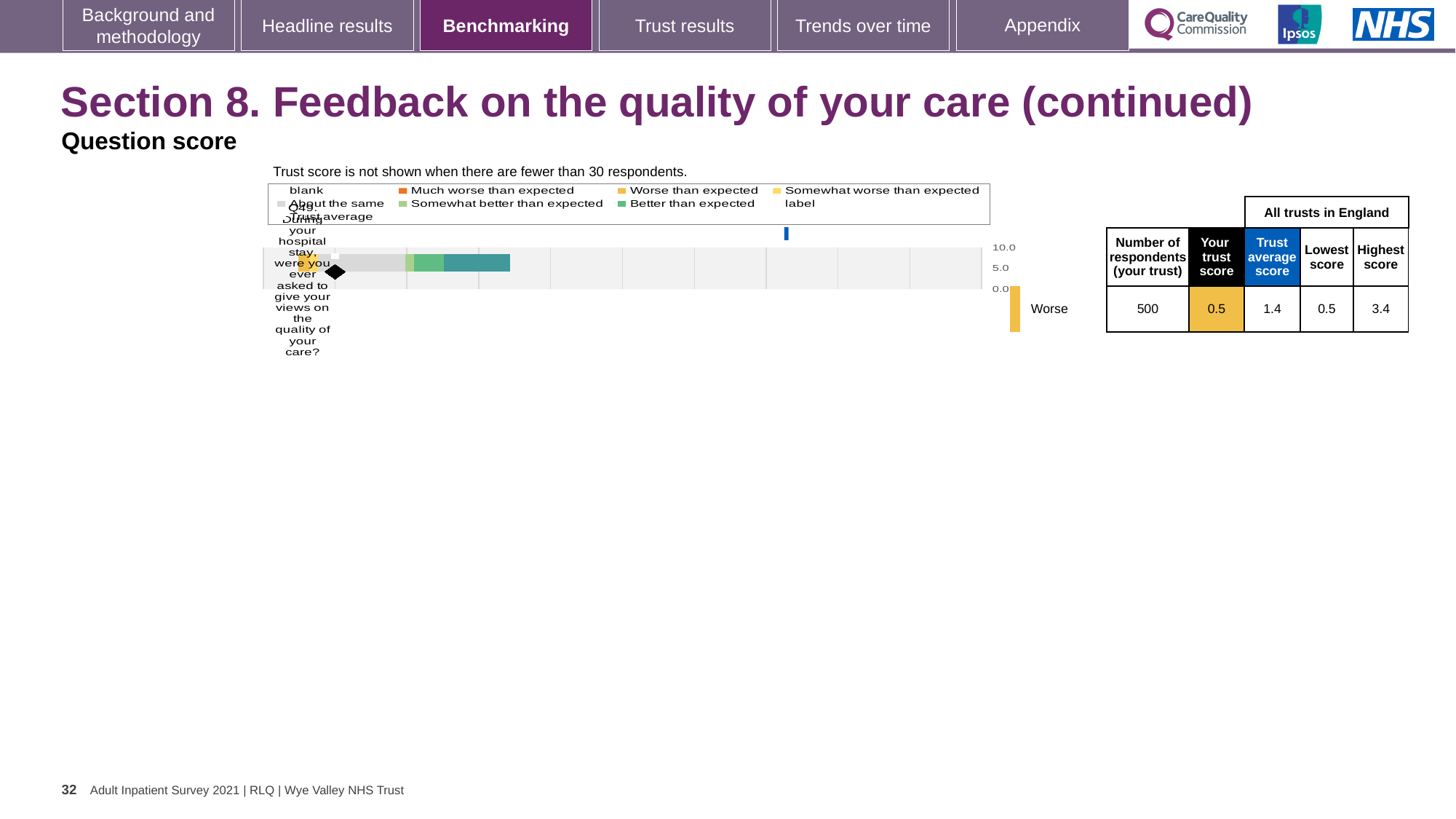
What is the lowest score among all trusts in England for Q49? 0.5 What is the difference between the trust average score and the trust score for Q49? 0.9 Is the trust score for Q49 greater or less than 5.0 on the chart axis? less Which is larger for Q49: the trust score or the trust average score? Trust average score What is the highest score among all trusts in England for Q49? 3.4 What is the trust score for Q49 shown in the table? 0.5 How many respondents from the trust answered Q49? 500 What benchmark category label is shown next to the yellow bar for Q49? Worse What kind of chart is used to show the benchmarking for Q49? Bar chart What is the trust average score for Q49 across all trusts in England? 1.4 What is the difference between the highest score and the lowest score for Q49 across all trusts in England? 2.9 Which legend entry is shown in orange on the chart? Much worse than expected